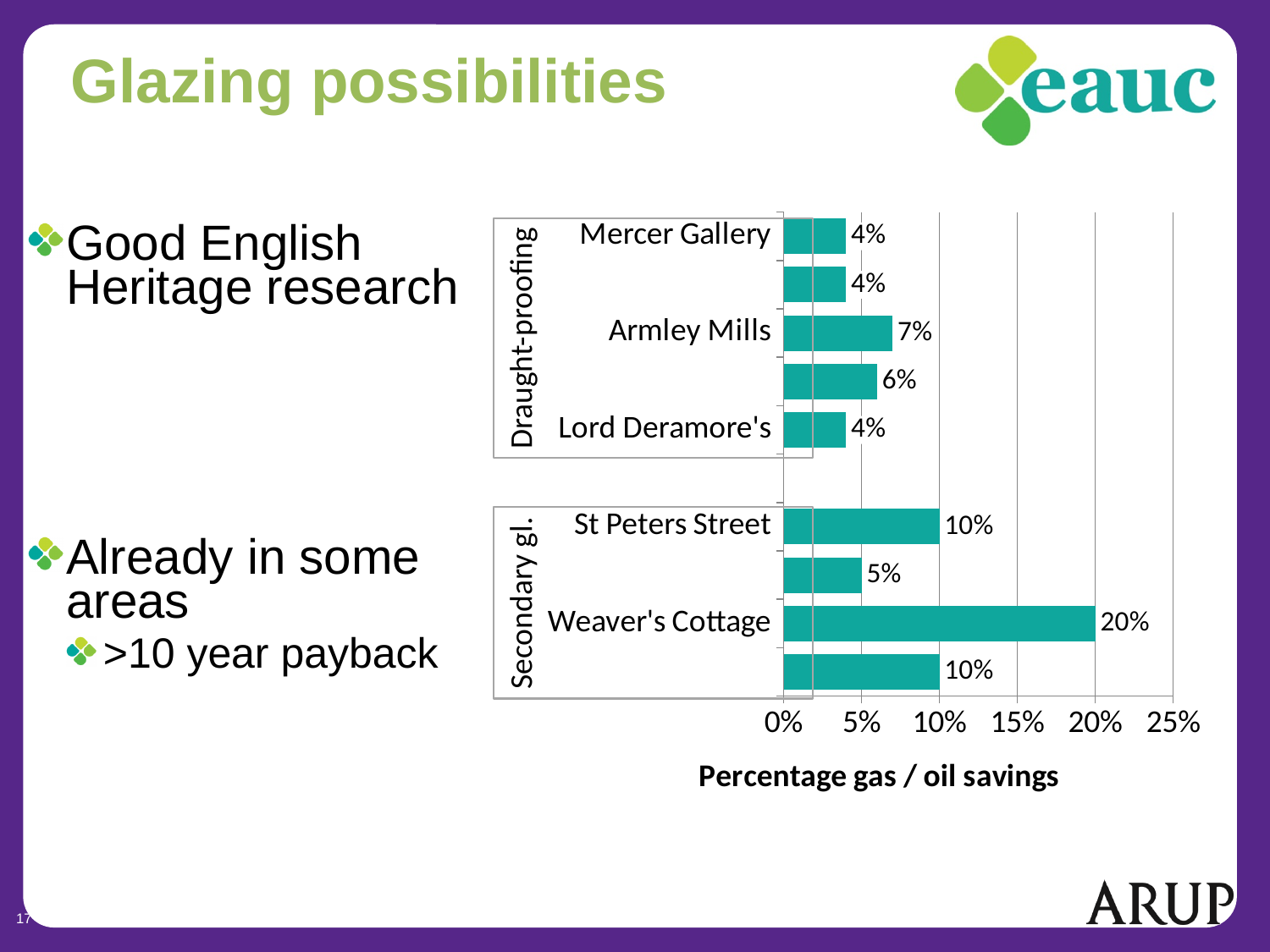
What is the difference between the savings for Weaver's Cottage and St Peters Street? 10% How many bars are plotted in the chart in total? 9 What kind of chart is shown on the slide? Bar chart Which has a larger percentage saving, Armley Mills or Mercer Gallery? Armley Mills Is the value for Weaver's Cottage greater or less than 15%? greater What is the percentage gas / oil saving shown for Mercer Gallery? 4% What is the percentage gas / oil saving shown for St Peters Street? 10% What is the percentage gas / oil saving shown for Lord Deramore's? 4% What is the percentage gas / oil saving shown for Weaver's Cottage? 20% What is the title of the horizontal axis of the chart? Percentage gas / oil savings Which labelled building has the highest percentage gas / oil saving? Weaver's Cottage What is the percentage gas / oil saving shown for Armley Mills? 7%